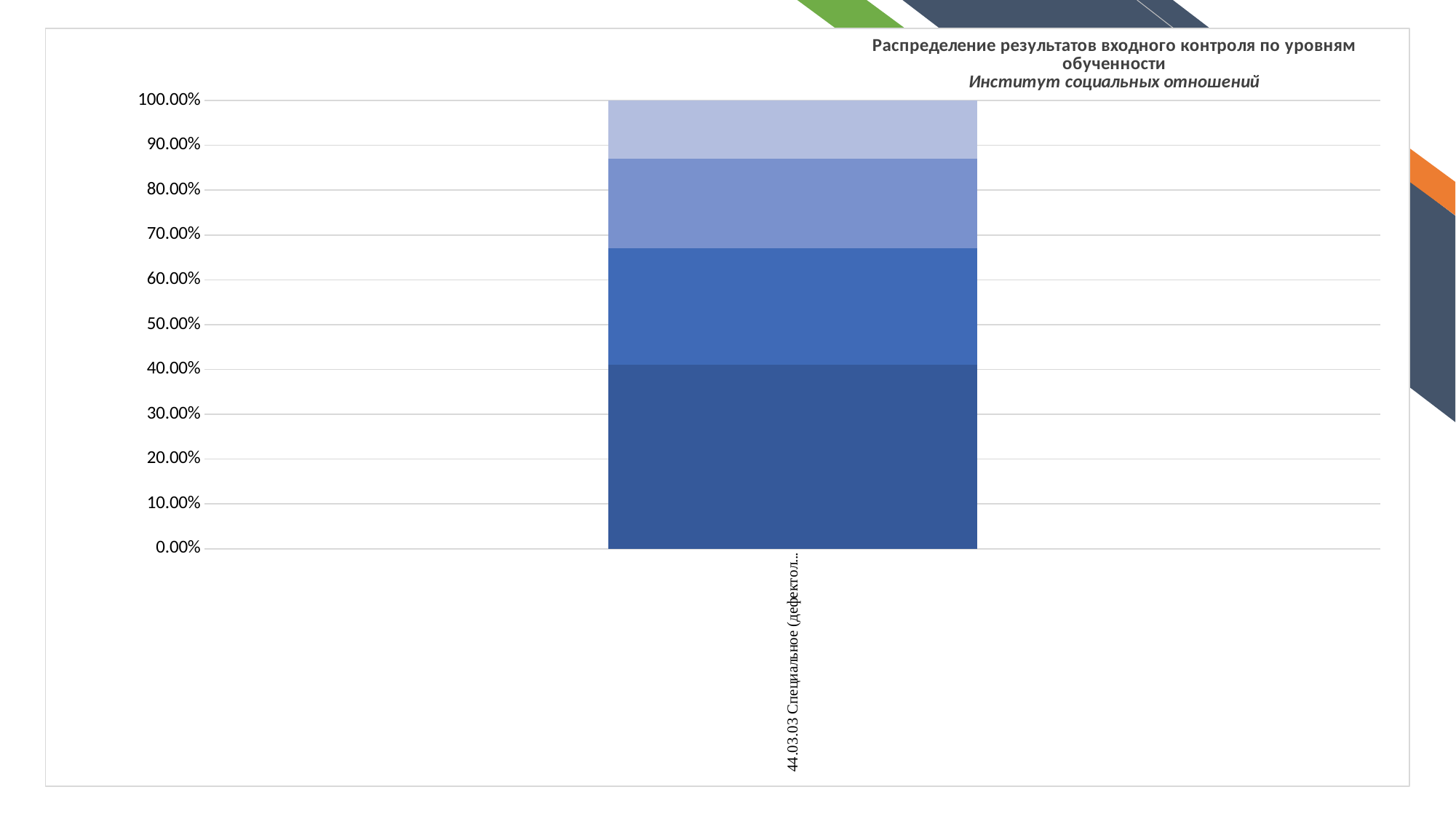
What is the first line of the chart title? Распределение результатов входного контроля по уровням обученности What is the highest value shown on the y axis of the chart? 100.00% Is the top of the third segment from the bottom greater or less than 90.00%? less Is the top of the second segment from the bottom (medium blue) greater or less than 60.00%? greater What kind of chart is shown on the slide? stacked bar chart What is the total height of the stacked bar, as read from the y axis? 100.00% Is the top of the bottom (darkest blue) segment of the bar greater or less than 50.00%? less How many stacked segments make up the single bar in the chart? 4 Which is larger: the bottom (darkest blue) segment or the top (lightest) segment of the bar? the bottom (darkest blue) segment Which segment of the stacked bar is the largest? the bottom (darkest blue) segment How many categories are plotted along the x axis of the chart? 1